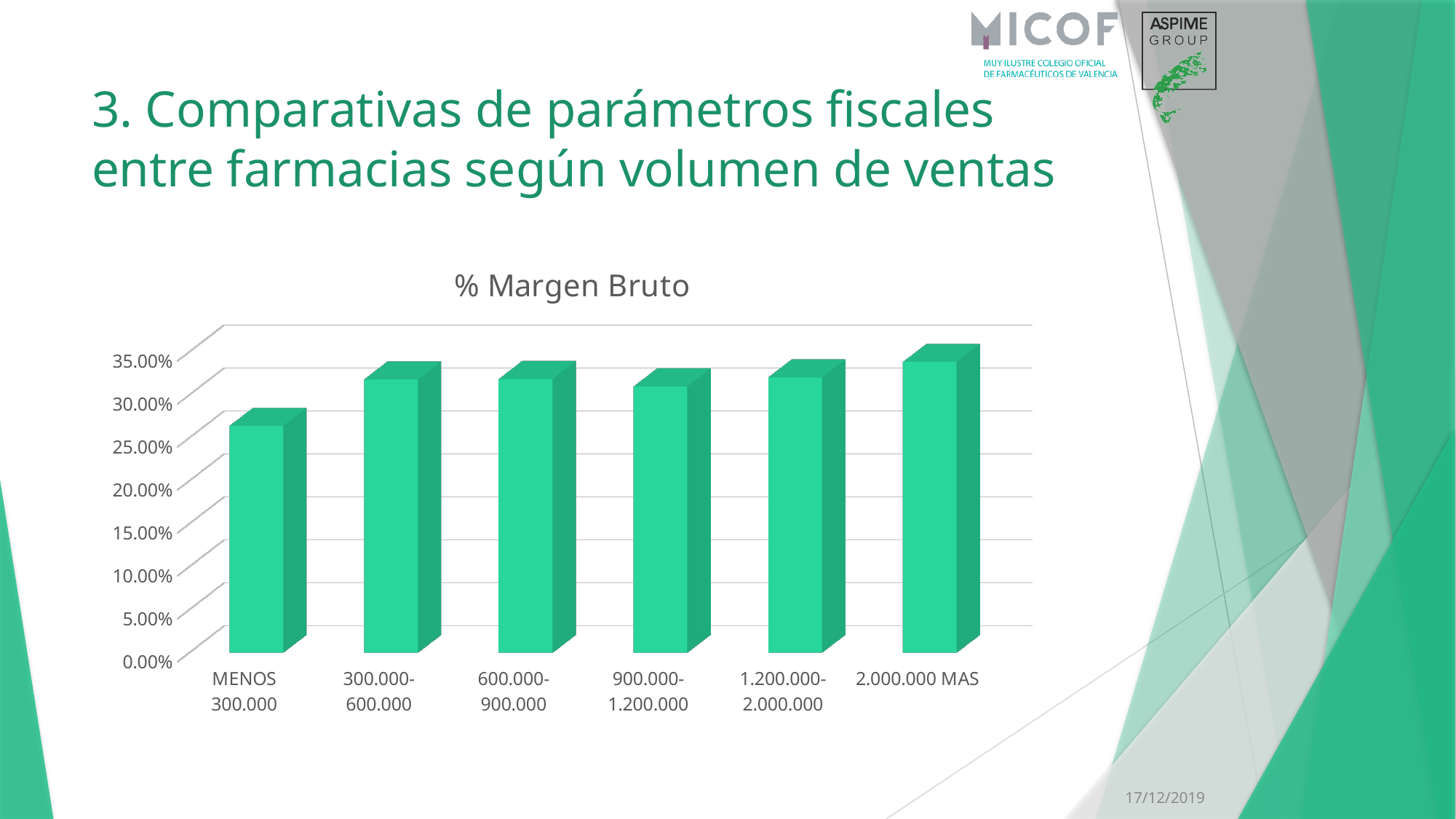
What is the label of the first category on the x axis? MENOS 300.000 Is the value for 2.000.000 MAS greater or less than 30.00%? greater What is the title of the chart? % Margen Bruto Which has a higher % Margen Bruto, 900.000-1.200.000 or 2.000.000 MAS? 2.000.000 MAS What type of chart is shown on the slide? bar chart Is the value for MENOS 300.000 greater or less than 25.00%? greater Is the value for 300.000-600.000 greater or less than 30.00%? greater Which category has the highest % Margen Bruto? 2.000.000 MAS How many categories are shown on the x axis of the chart? 6 Which category has the lowest % Margen Bruto? MENOS 300.000 Which has a higher % Margen Bruto, MENOS 300.000 or 2.000.000 MAS? 2.000.000 MAS